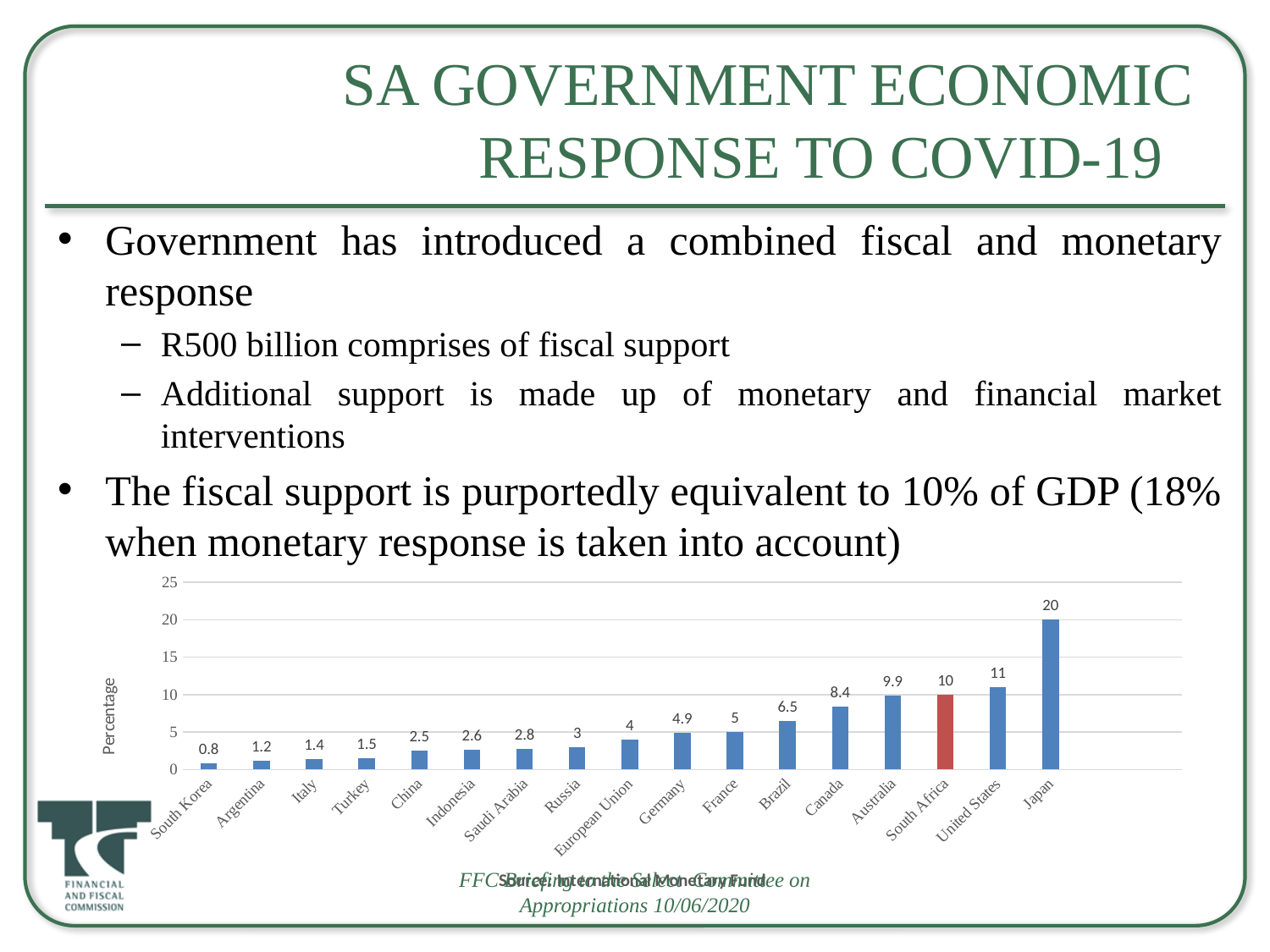
What is the difference between the values for South Africa and Canada? 1.6 Which country has the lowest value? South Korea Which country's bar is coloured red rather than blue? South Africa Which country has the highest value? Japan What is the value for South Africa? 10 How many countries are shown on the x axis? 17 What is the value for Japan? 20 Do the values rise or fall moving from left to right along the x axis? Rise Which is larger, the value for Germany or the value for Brazil? Brazil What is the difference between the values for Japan and United States? 9 What is the value for Brazil? 6.5 What kind of chart is shown on the slide? Bar chart